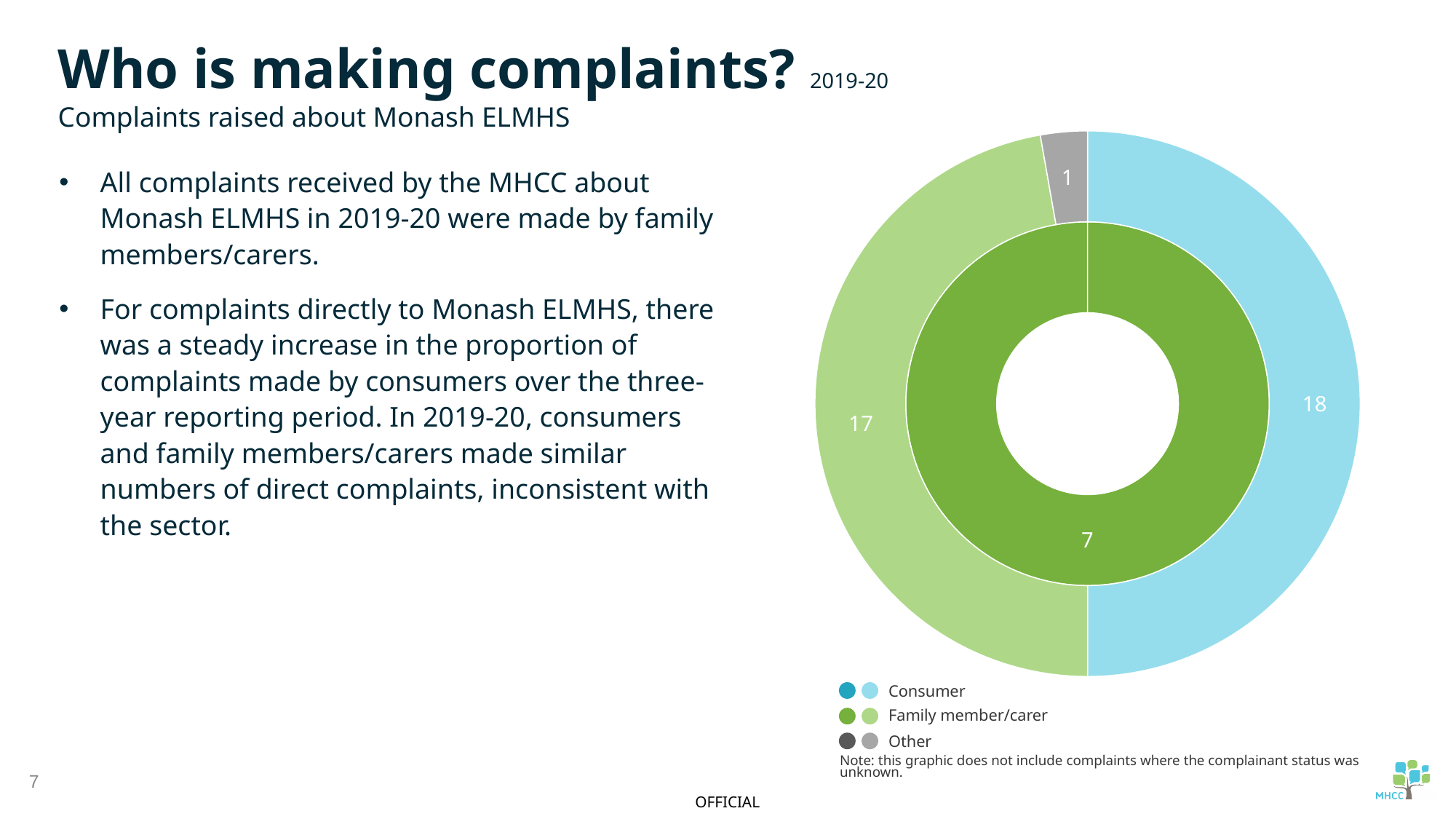
What type of chart is shown on the slide? Doughnut chart What share of the outer ring total does the Consumer segment represent? 50% In the outer ring of the chart, what is the value for Family member/carer? 17 In the outer ring of the chart, what is the value for Other? 1 What is the value shown in the inner ring of the chart? 7 What is the total of the values in the outer ring of the chart? 36 Which category has the smallest value in the outer ring of the chart? Other Which category has the largest value in the outer ring of the chart? Consumer In the outer ring, what is the difference between the Consumer value and the Family member/carer value? 1 In the outer ring of the chart, what is the value for Consumer? 18 How many entries does the chart legend list? 3 In the outer ring, is the value for Consumer or Other larger? Consumer